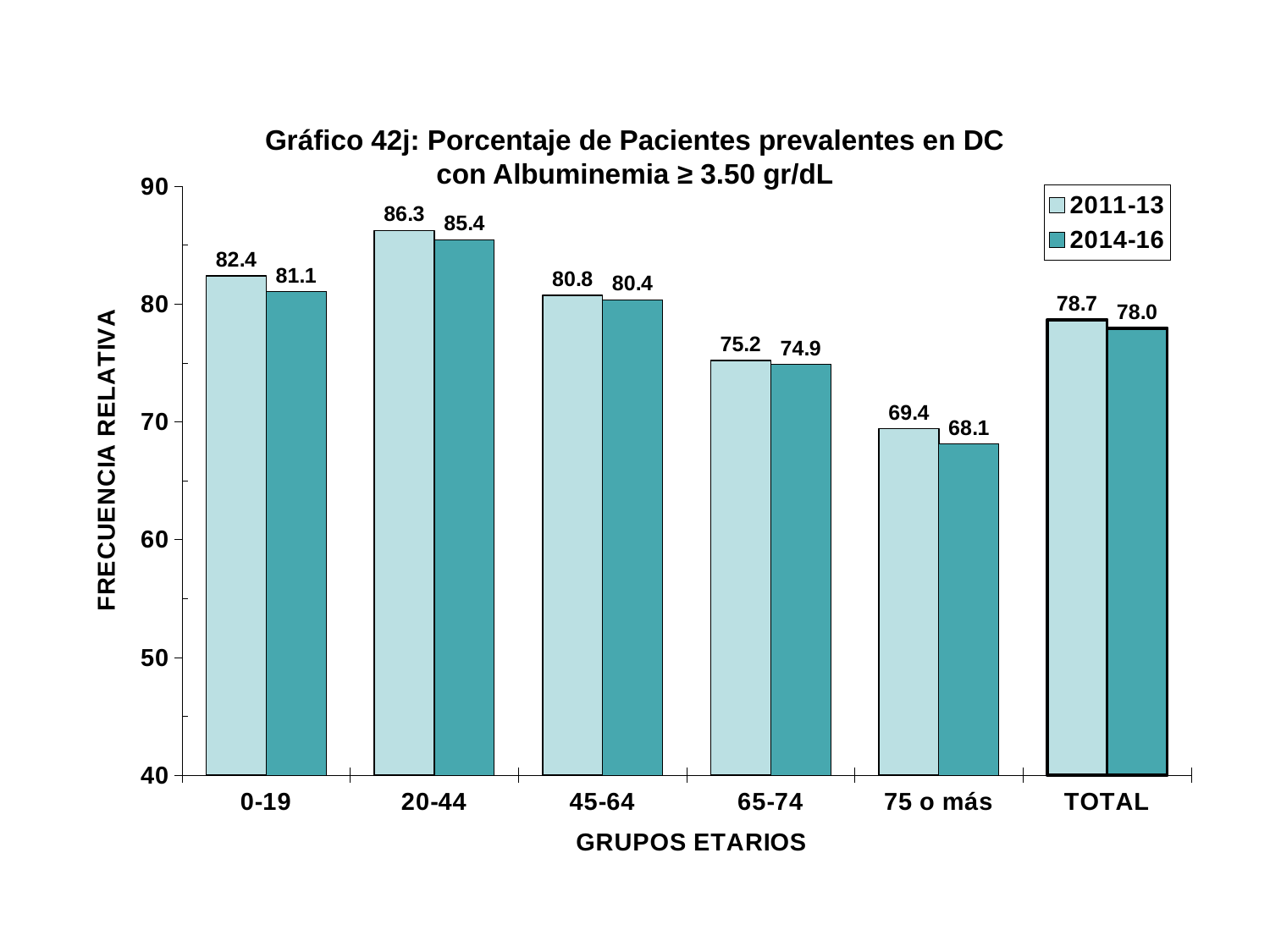
Which age group has the lowest value for the 2014-16 series? 75 o más How many categories are shown on the x axis? 6 What kind of chart is shown on the slide? bar chart What is the value for the 2011-13 series in the 0-19 age group? 82.4 What is the difference between the 2011-13 and 2014-16 values in the 75 o más age group? 1.3 Is the 2014-16 value for the 65-74 age group greater or less than 80? less What is the TOTAL value for the 2014-16 series? 78.0 Which is larger in the 45-64 age group: the 2011-13 value or the 2014-16 value? 2011-13 Which age group has the highest value for the 2011-13 series? 20-44 How many series does the legend list? 2 What is the value for the 2014-16 series in the 75 o más age group? 68.1 What is the label of the y axis? FRECUENCIA RELATIVA